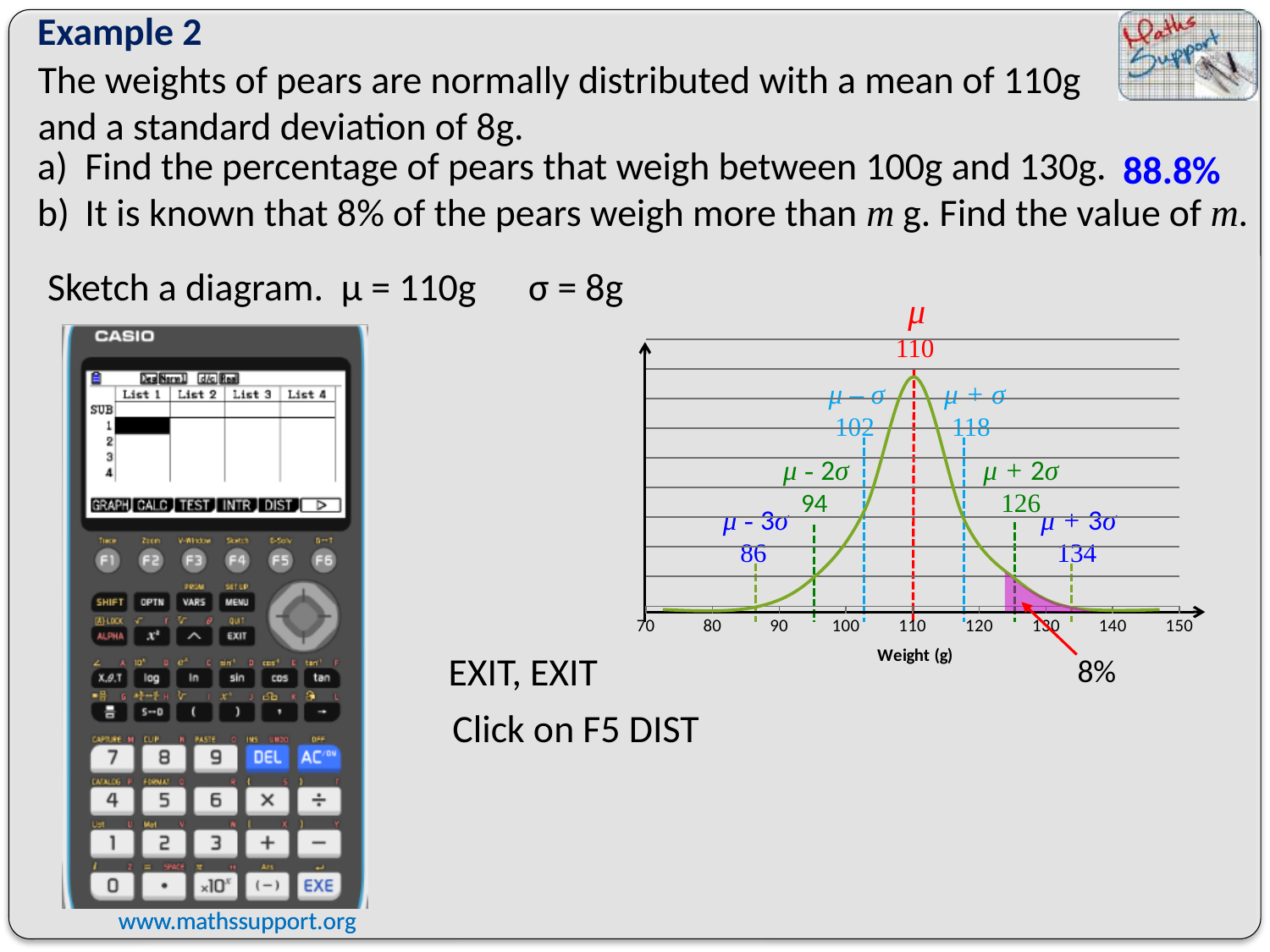
What value is labelled at μ + σ on the chart? 118 What is the difference between the values labelled at μ + 3σ and μ − 3σ on the chart? 48 What value is labelled at μ − σ on the chart? 102 What value is labelled at μ − 3σ on the chart? 86 What is the lowest value shown on the x axis of the chart? 70 What value is labelled at μ + 2σ on the chart? 126 What value is marked at the mean (μ) on the normal distribution chart? 110 What is the x-axis label of the normal distribution chart? Weight (g) What value is labelled at μ − 2σ on the chart? 94 What percentage is indicated for the shaded region in the right tail of the chart? 8% What is the highest value shown on the x axis of the chart? 150 What value is labelled at μ + 3σ on the chart? 134